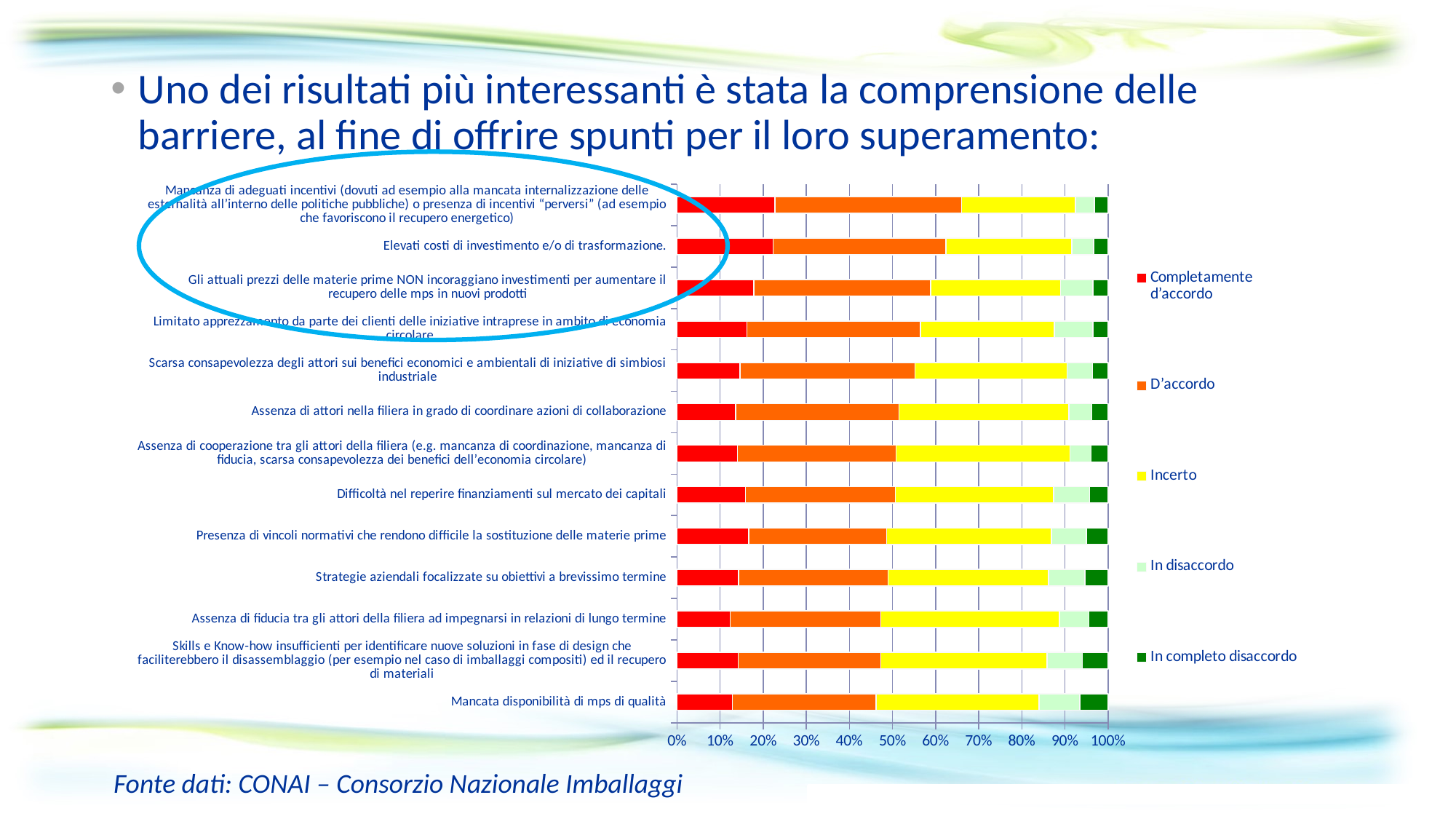
Is the "Incerto" share for "Mancata disponibilità di mps di qualità" greater or less than 30%? greater What is the first entry in the chart legend? Completamente d'accordo Which has the larger "Completamente d'accordo" share: "Elevati costi di investimento e/o di trasformazione" or "Mancata disponibilità di mps di qualità"? Elevati costi di investimento e/o di trasformazione What is the total of each stacked bar in the chart? 100% Which has the larger "Incerto" share: "Mancata disponibilità di mps di qualità" or "Mancanza di adeguati incentivi"? Mancata disponibilità di mps di qualità What kind of chart is shown on the slide? Stacked bar chart Is the "Completamente d'accordo" share for "Elevati costi di investimento e/o di trasformazione" greater or less than 20%? greater How many barrier categories are plotted in the chart? 13 Is the "Completamente d'accordo" share for "Assenza di fiducia tra gli attori della filiera ad impegnarsi in relazioni di lungo termine" greater or less than 10%? greater Which colour represents the series "Incerto" in the chart? Yellow How many series does the chart legend list? 5